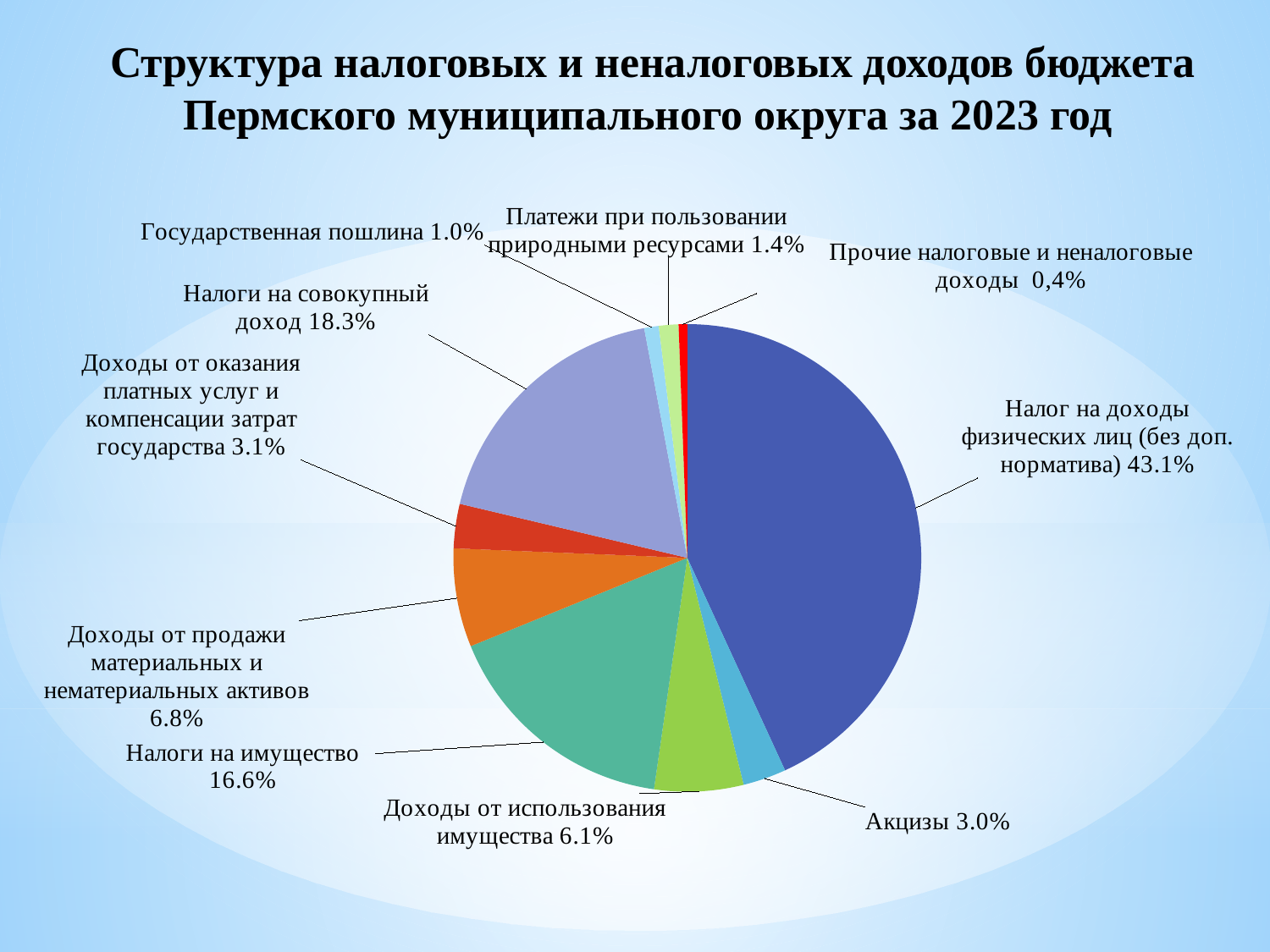
Какую долю составляет «Налог на доходы физических лиц (без доп. норматива)»? 43.1% Какая категория имеет наименьшую долю в структуре доходов? Прочие налоговые и неналоговые доходы Что больше: доля «Доходы от продажи материальных и нематериальных активов» или доля «Доходы от использования имущества»? Доходы от продажи материальных и нематериальных активов Какая категория имеет наибольшую долю в структуре доходов? Налог на доходы физических лиц (без доп. норматива) Сколько категорий показано на круговой диаграмме? 10 Какую долю составляют «Доходы от использования имущества»? 6.1% Какой тип диаграммы показан на слайде? Круговая диаграмма Какую долю составляют «Прочие налоговые и неналоговые доходы»? 0,4% На сколько процентных пунктов доля «Налоги на совокупный доход» больше доли «Налоги на имущество»? 1.7 Какую долю составляют «Налоги на имущество»? 16.6% За какой год показана структура доходов бюджета в заголовке слайда? 2023 год Какую долю составляют «Акцизы»? 3.0%